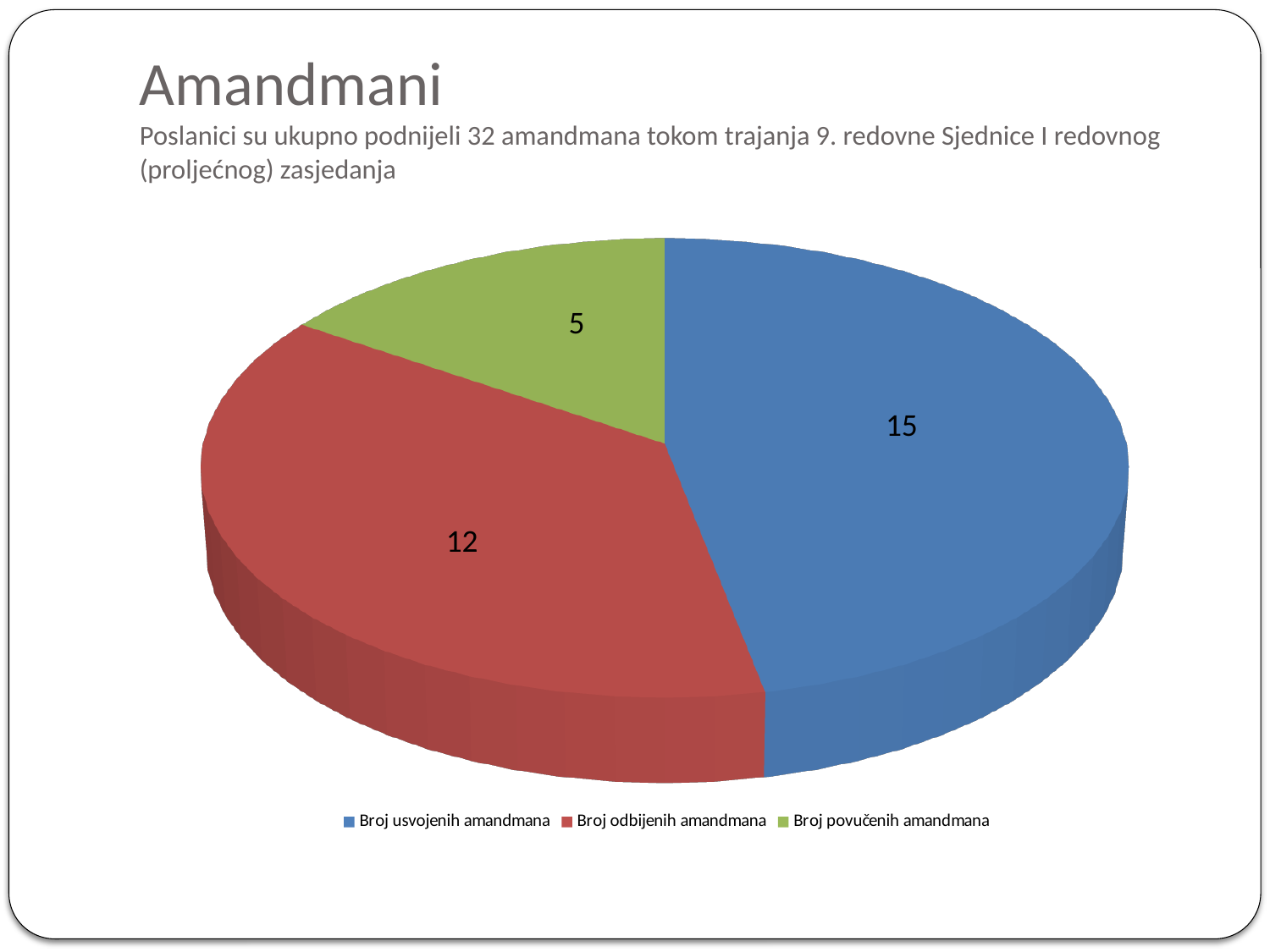
Which is larger, Broj odbijenih amandmana or Broj povučenih amandmana? Broj odbijenih amandmana How many slices does the pie chart have? 3 What is the value for Broj odbijenih amandmana? 12 What is the total of all slices in the pie chart? 32 What type of chart is shown on the slide? pie chart What is the difference between Broj odbijenih amandmana and Broj povučenih amandmana? 7 Which colour represents Broj odbijenih amandmana in the pie chart? red What is the value for Broj povučenih amandmana? 5 Which category has the smallest slice of the pie? Broj povučenih amandmana What is the difference between Broj usvojenih amandmana and Broj odbijenih amandmana? 3 What is the value for Broj usvojenih amandmana? 15 Which category has the largest slice of the pie? Broj usvojenih amandmana